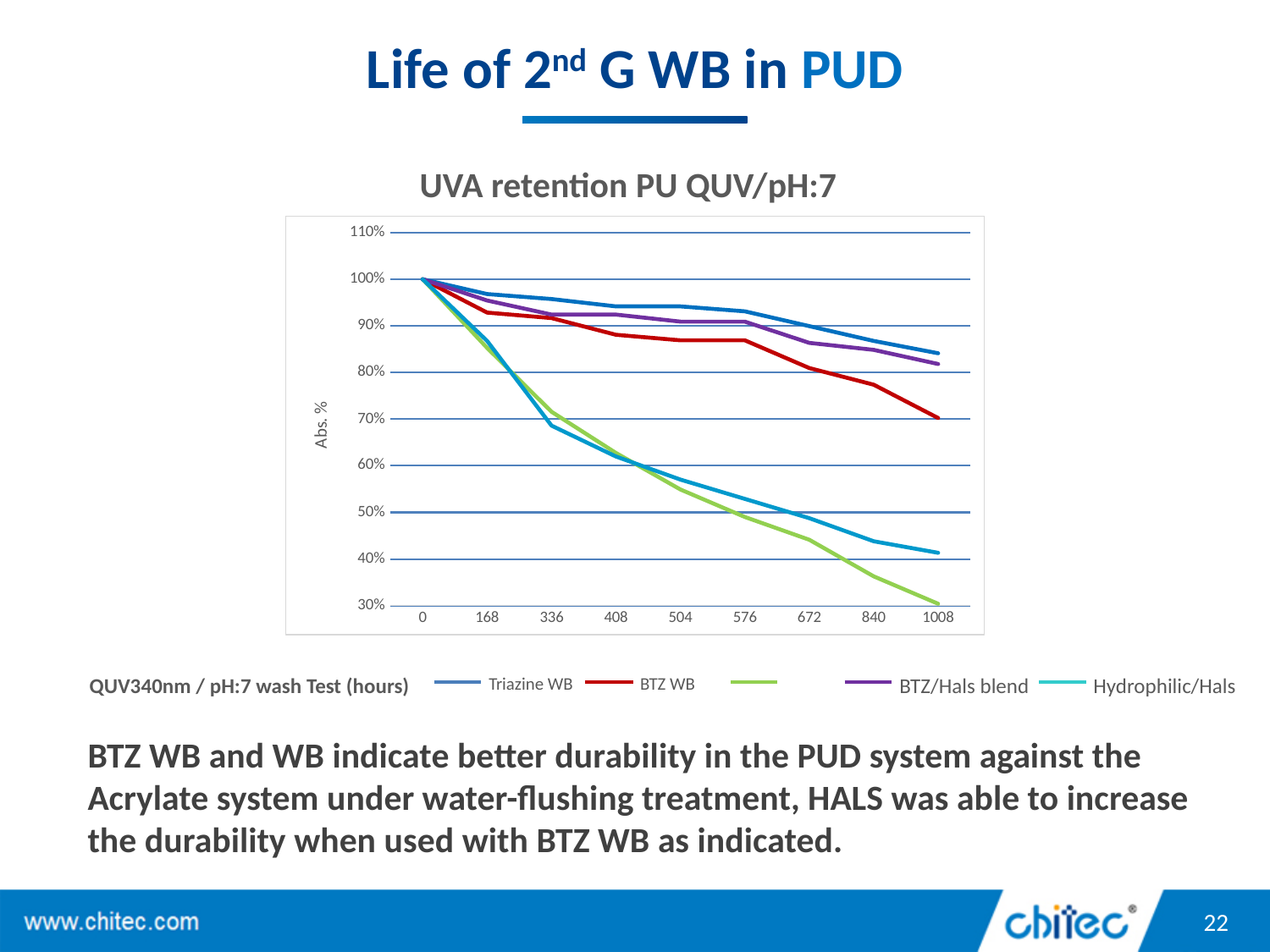
What kind of chart is shown on the slide? line chart What is the title of the chart? UVA retention PU QUV/pH:7 Is the value for Triazine WB at 1008 hours greater or less than 80%? greater What is the label on the vertical axis of the chart? Abs. % What is the value for Triazine WB at 0 hours? 100% Is the value for Hydrophilic/Hals at 1008 hours greater or less than 50%? less At 1008 hours, which is higher: Triazine WB or BTZ WB? Triazine WB How many time points are marked along the x axis of the chart? 9 Is the value for BTZ WB at 840 hours greater or less than 80%? less Do the values for BTZ WB rise or fall as the hours increase along the x axis? fall How many series are plotted in the chart? 5